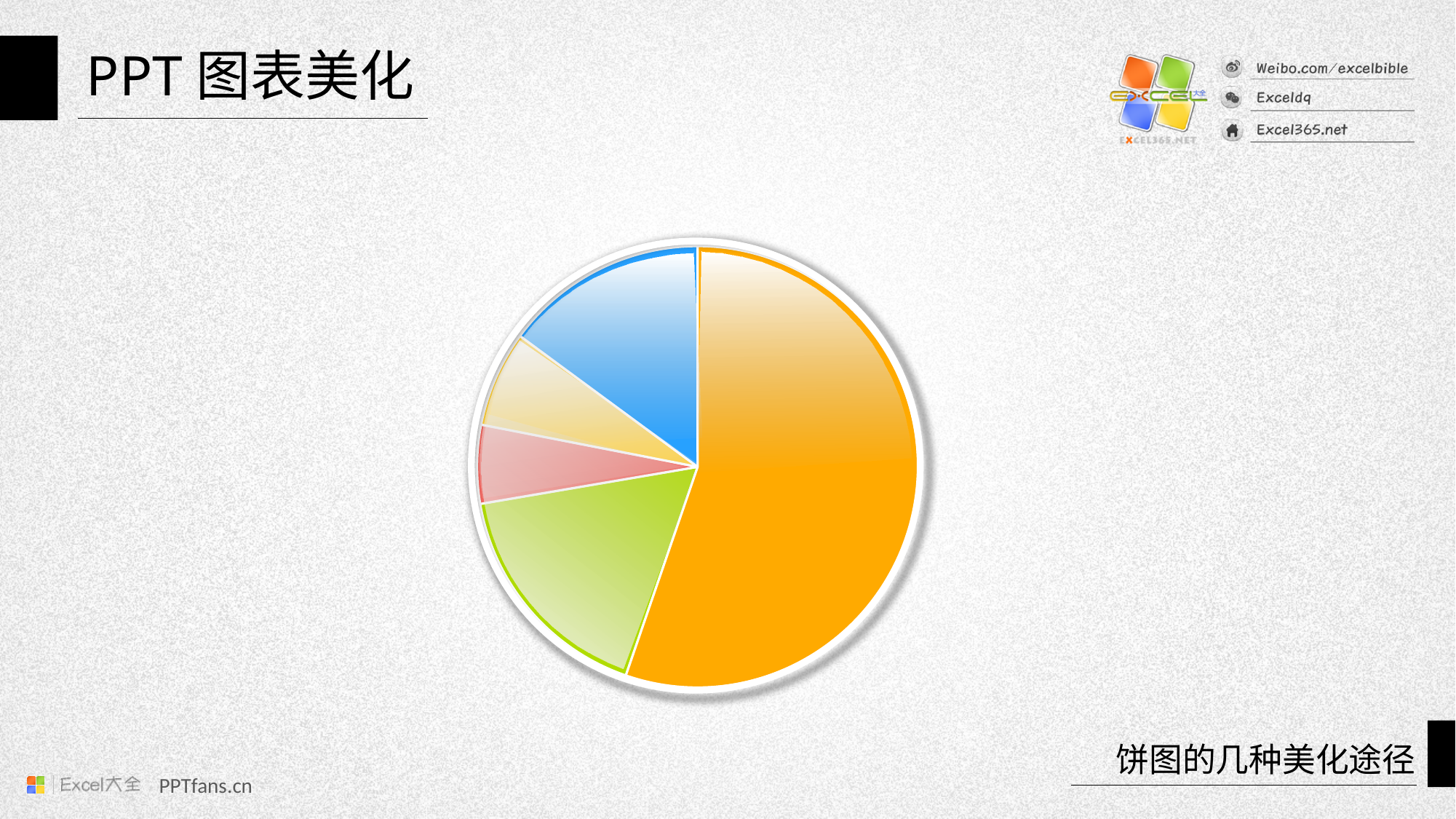
What kind of chart is shown on the slide? pie chart Does the pie chart display a legend? No Which colour slice is the largest in the pie chart? orange What is the title text at the top of the slide? PPT 图表美化 Which slice is larger, the green slice or the light yellow slice? green Which colour slice is the smallest in the pie chart? pink How many slices does the pie chart have? 5 Which slice is larger, the blue slice or the pink slice? blue